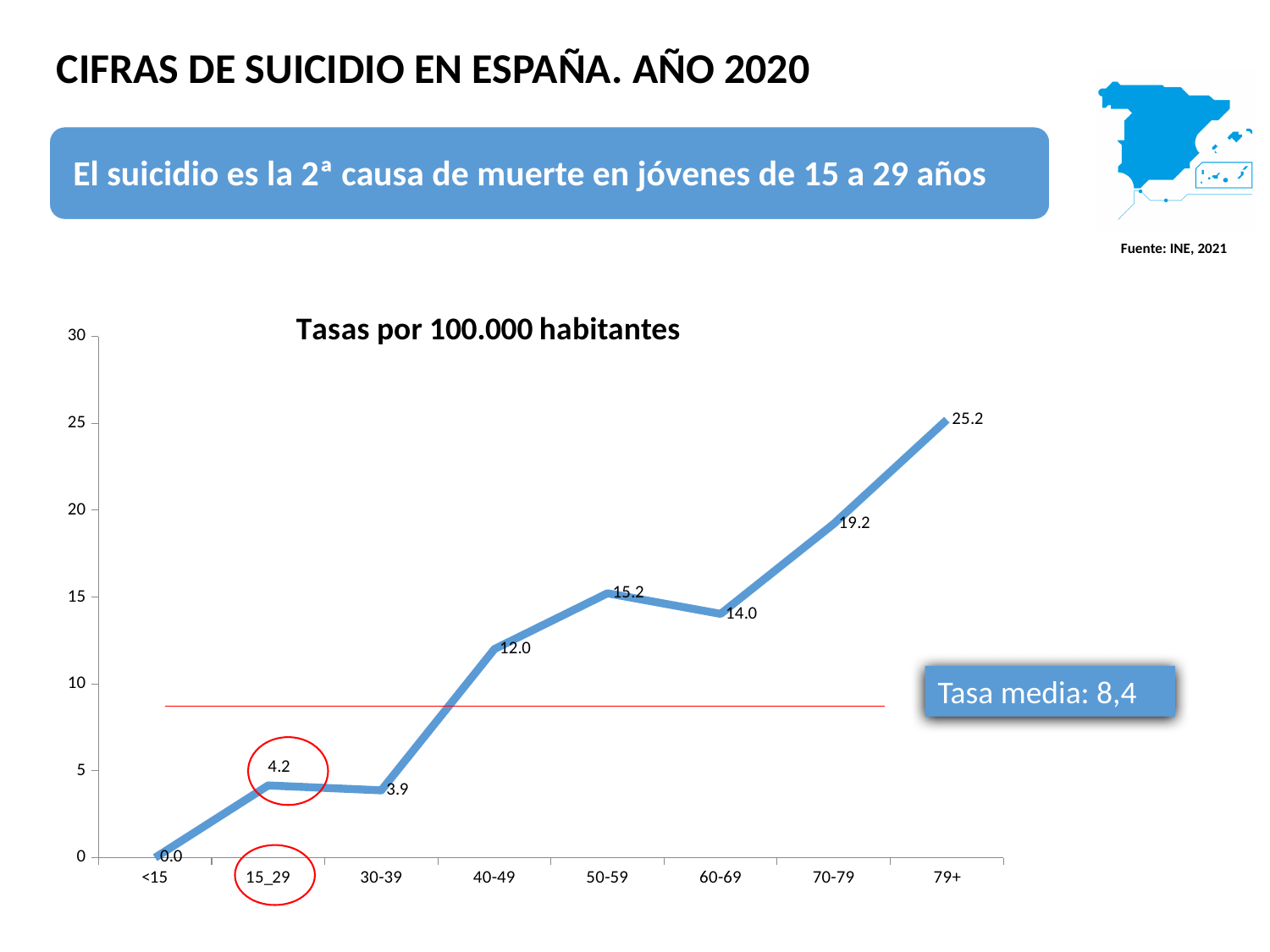
Is the value for 60-69 greater or less than 10? greater What is the difference between the values for 79+ and 70-79? 6.0 What is the title of the chart? Tasas por 100.000 habitantes Which age group has the lowest value? <15 Which age group has the highest value? 79+ Do the values generally rise or fall from the <15 group to the 79+ group? rise What is the value for the 15_29 age group? 4.2 What is the value for the 70-79 age group? 19.2 What kind of chart is shown on the slide? line chart Which is larger, the value for 50-59 or the value for 60-69? 50-59 What is the value for the 40-49 age group? 12.0 How many age groups are plotted on the x axis? 8